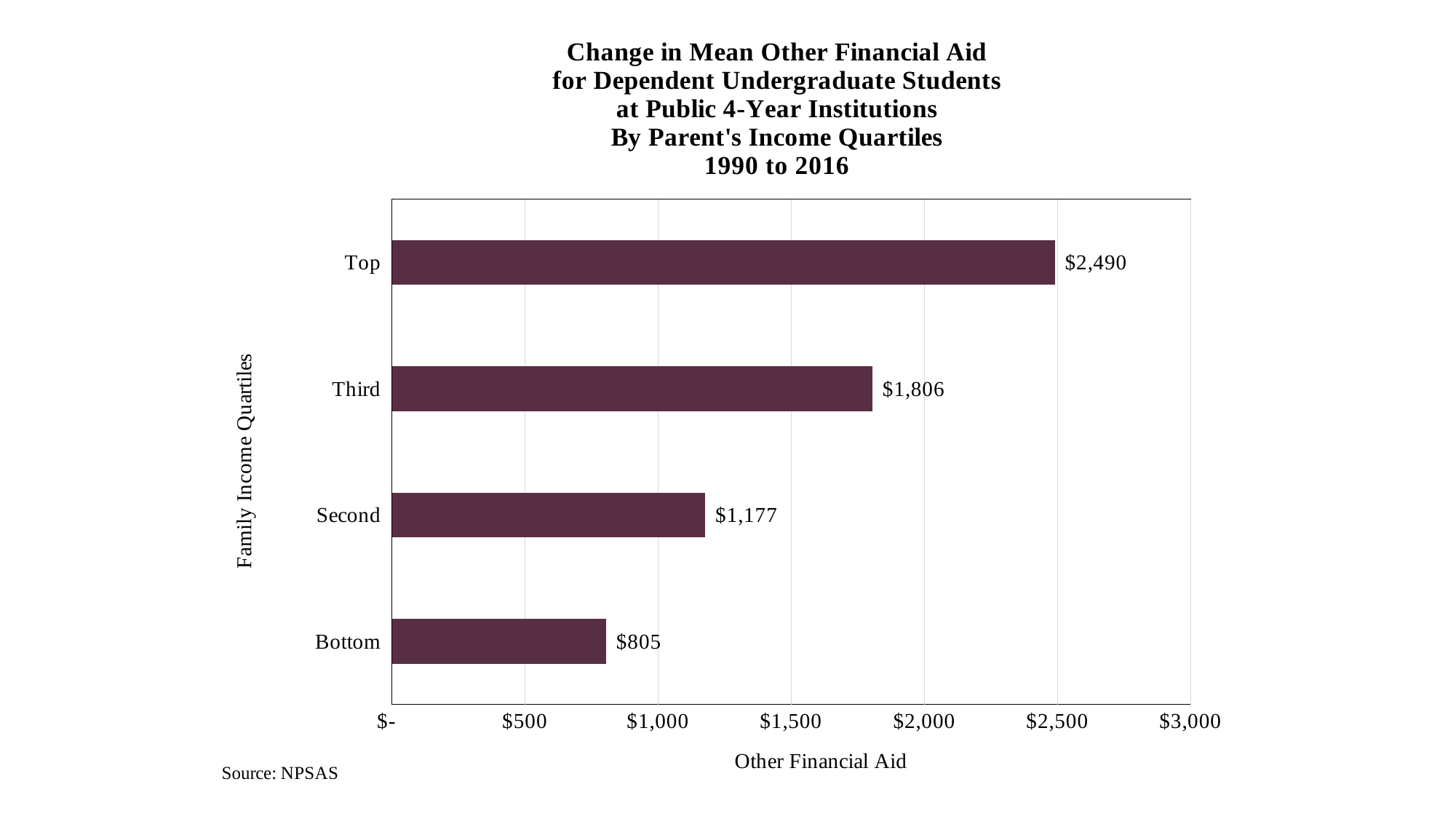
Which quartile has the lowest value? Bottom What is the value for the Third quartile? $1,806 What is the value for the Bottom quartile? $805 What is the difference between the Top and Bottom quartile values? $1,685 What is the difference between the Third and Second quartile values? $629 Which quartile has the highest value? Top Which is larger, the value for Third or the value for Second? Third How many quartile categories are shown in the chart? 4 What kind of chart is shown on the slide? Bar chart Is the value for Second greater or less than $1,000? greater What is the value for the Second quartile? $1,177 What is the value for the Top quartile? $2,490